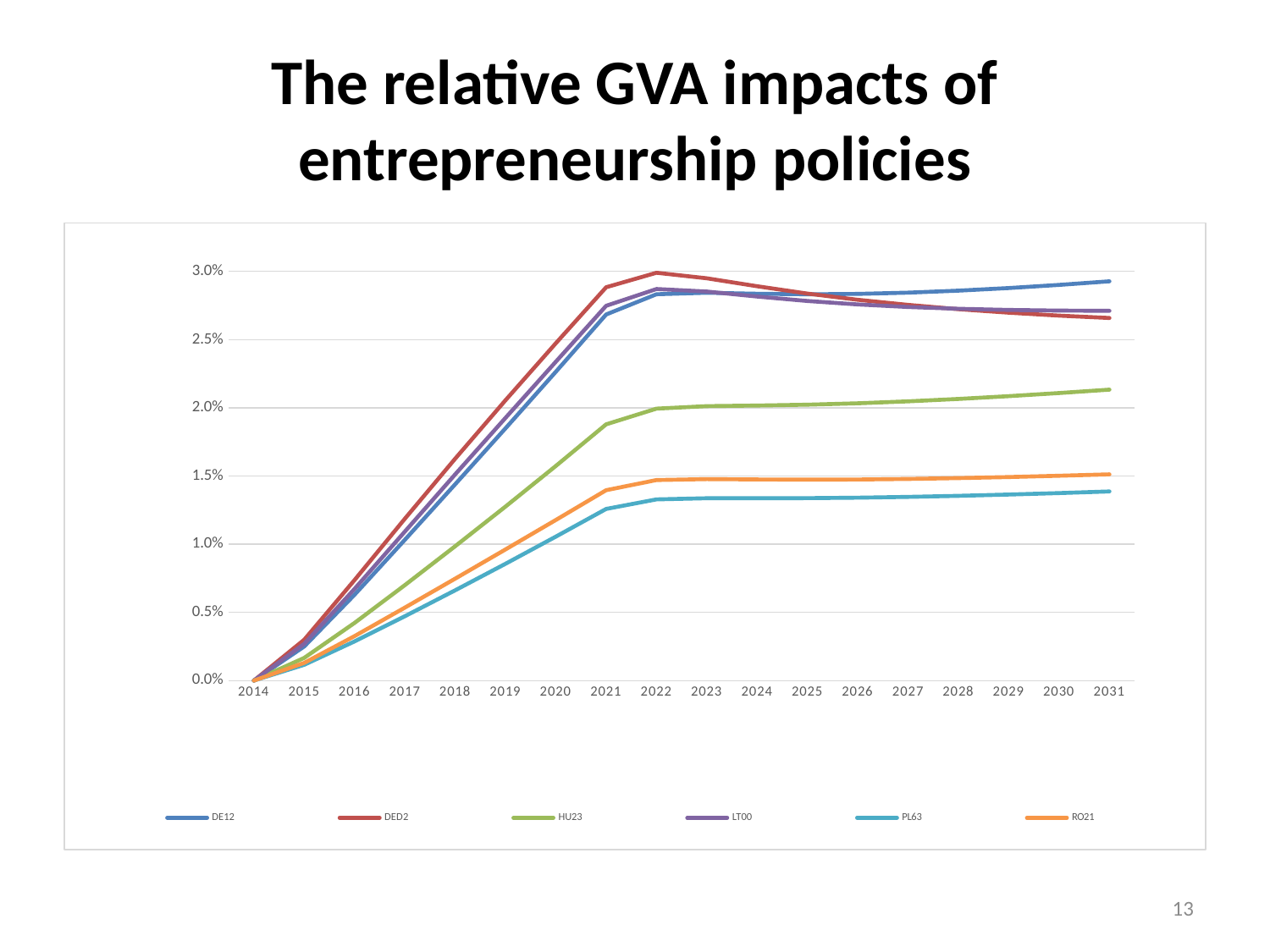
What is the value for DE12 in 2014? 0.0% Does the DED2 line rise or fall from 2022 to 2031? fall What kind of chart is shown on the slide? line chart Is the value for HU23 in 2021 greater or less than 2.0%? less Which series has the highest value in 2031? DE12 How many years are shown along the x axis? 18 Which series has the lowest value in 2031? PL63 Is the value for HU23 in 2031 greater or less than 2.0%? greater How many series does the legend list? 6 What is the title of the chart on the slide? The relative GVA impacts of entrepreneurship policies Is the value for PL63 in 2031 greater or less than 1.5%? less Which is larger in 2031, the value for HU23 or the value for RO21? HU23